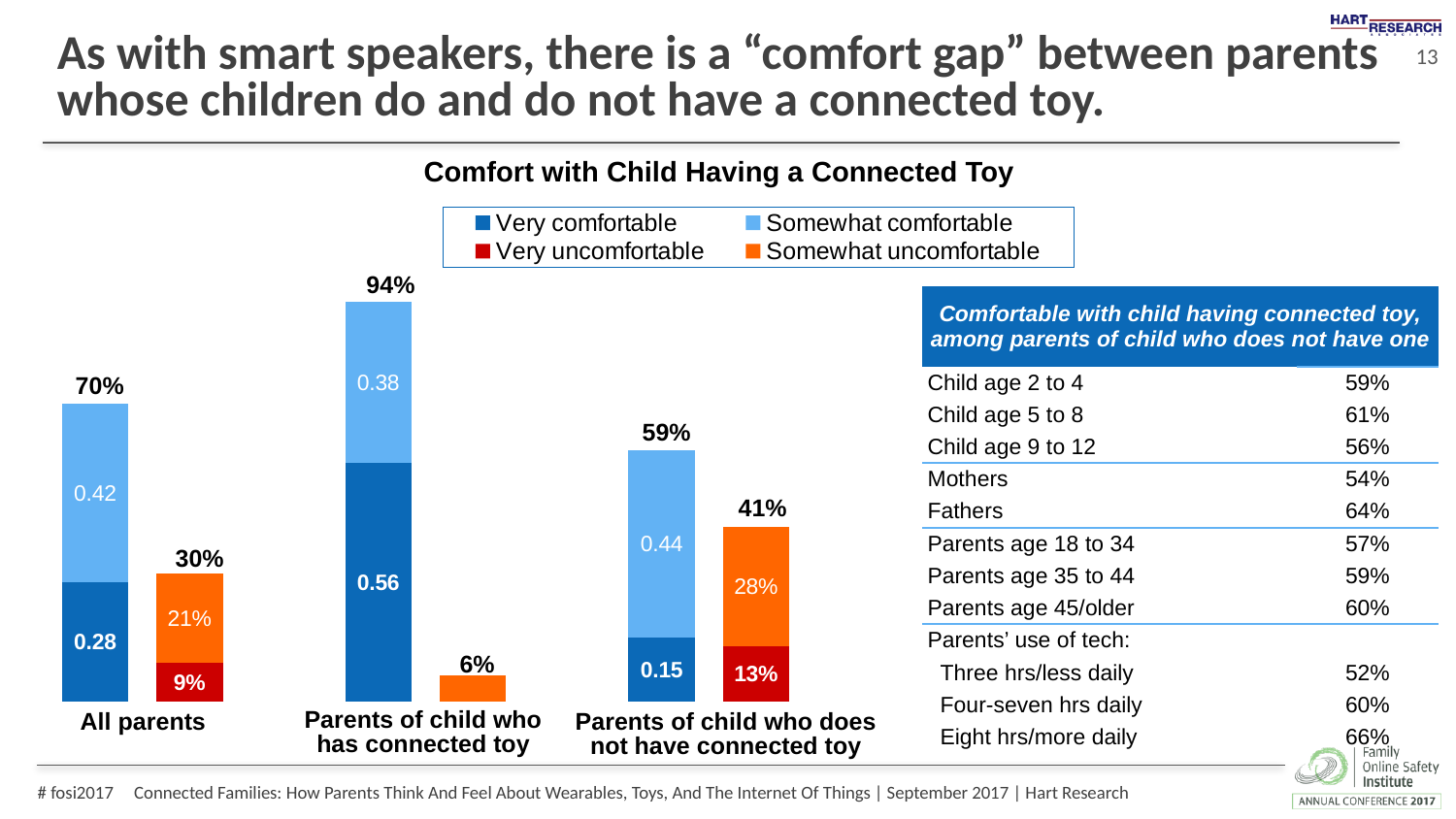
What is the total comfortable share (Very comfortable plus Somewhat comfortable) for All parents? 70% Which parent group has the lowest total uncomfortable share? Parents of child who has connected toy What is the Very comfortable value for Parents of child who has connected toy? 0.56 What is the total comfortable share for Parents of child who has connected toy? 94% What is the Somewhat comfortable value for All parents? 0.42 Which parent group has the highest total comfortable share? Parents of child who has connected toy How many series does the chart legend list? 4 What is the title of the chart? Comfort with Child Having a Connected Toy What kind of chart is shown on the slide? Stacked bar chart What is the difference between the total comfortable share for Parents of child who has connected toy (94%) and Parents of child who does not have connected toy (59%)? 35% What is the Somewhat uncomfortable value for All parents? 21% What is the Very uncomfortable value for Parents of child who does not have connected toy? 13%